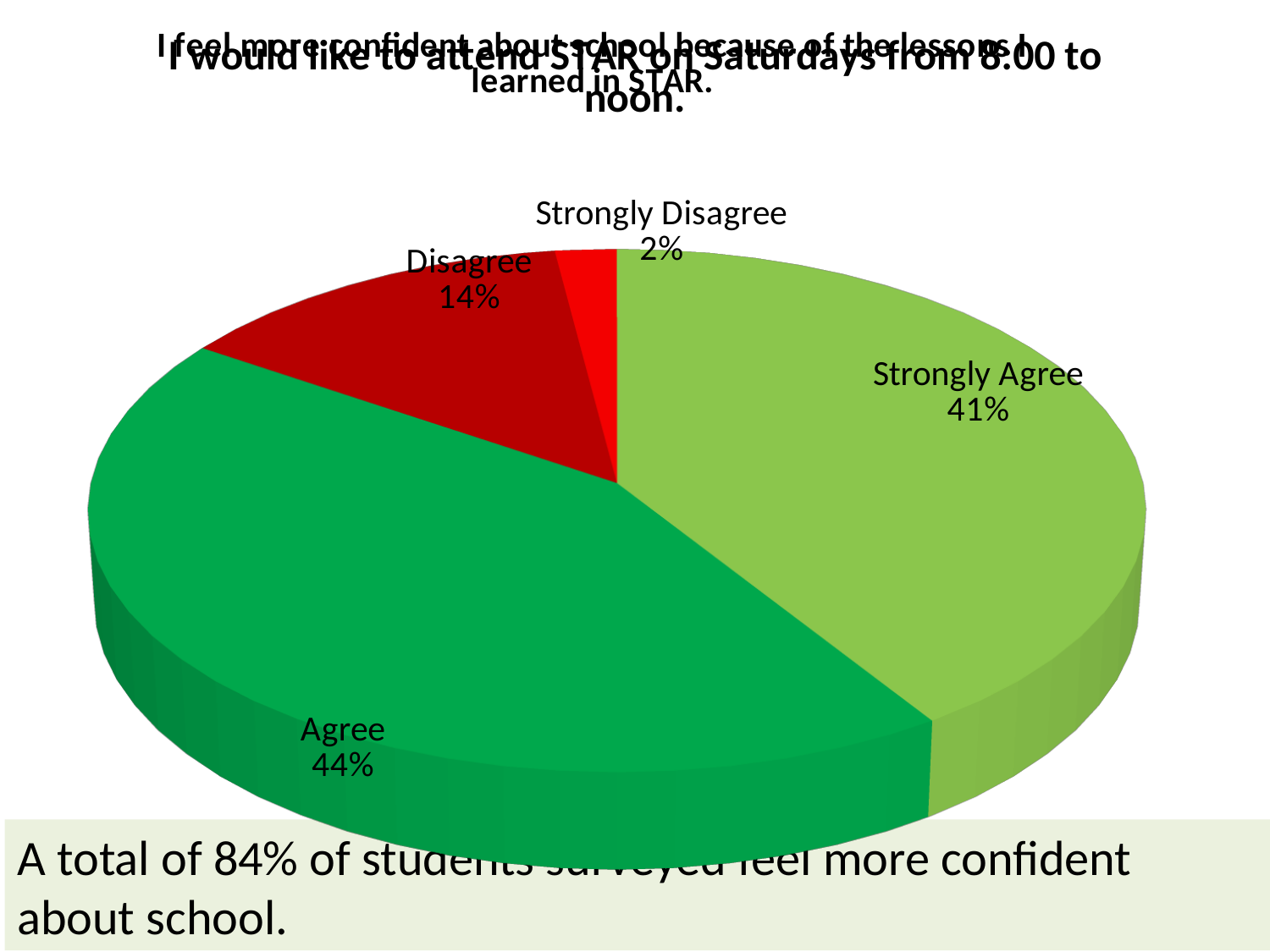
Which category has the largest slice of the pie chart? Agree What percentage of the pie chart is labelled Agree? 44% How many categories are shown in the pie chart? 4 What percentage of the pie chart is labelled Strongly Agree? 41% What percentage of the pie chart is labelled Strongly Disagree? 2% Which category has the smallest slice of the pie chart? Strongly Disagree What kind of chart is shown on the slide? Pie chart What is the difference in percentage points between the Agree and Disagree slices? 30 What percentage of the pie chart is labelled Disagree? 14% Which slice is larger, Strongly Agree or Disagree? Strongly Agree What is the difference in percentage points between the Disagree and Strongly Disagree slices? 12